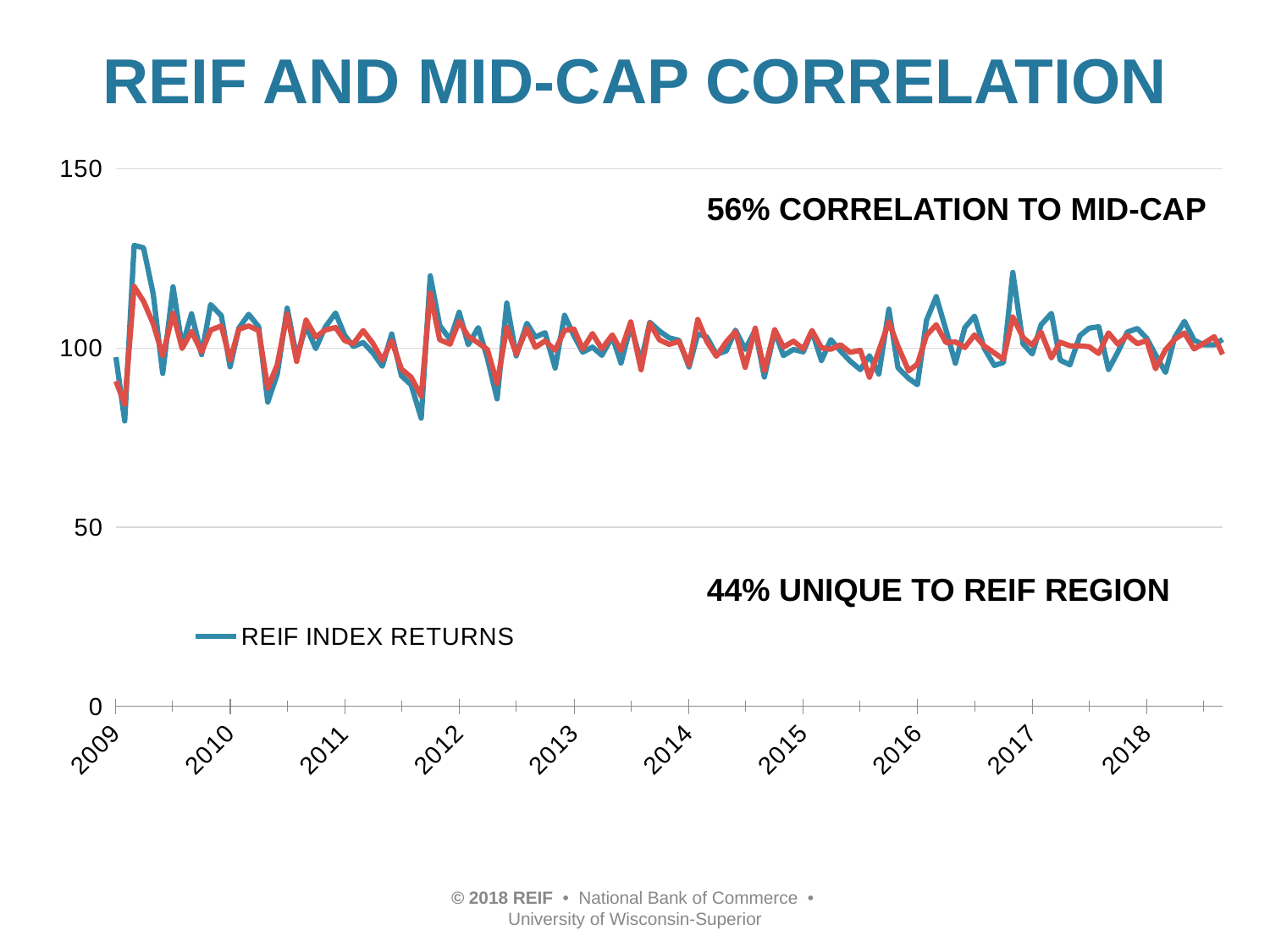
What series name appears in the chart legend? REIF INDEX RETURNS How many year labels are shown on the x axis? 10 What is the first year label on the x axis? 2009 Is the lowest value of the blue REIF INDEX RETURNS line greater or less than 50? greater What is the title of the chart slide? REIF AND MID-CAP CORRELATION Is the highest peak of the blue REIF INDEX RETURNS line in 2009 greater or less than 100? greater Is the highest value of the blue REIF INDEX RETURNS line greater or less than 150? less What is the highest value shown on the y axis? 150 What kind of chart is shown on the slide? line chart How many series does the chart legend list? 1 What is the last year label on the x axis? 2018